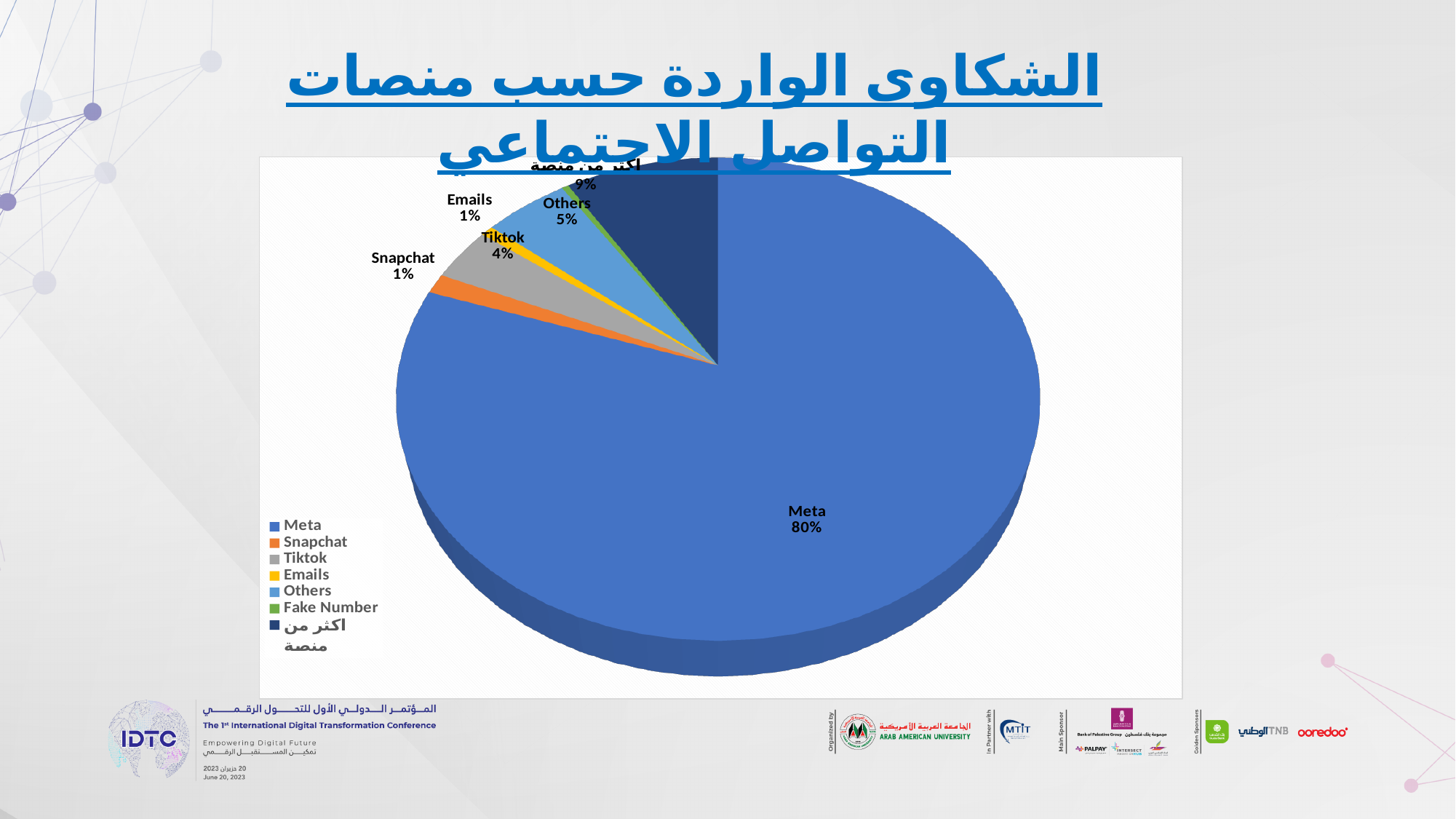
What percentage of complaints is attributed to Emails? 1% What colour is the Meta slice in the pie chart? Blue What percentage of complaints is attributed to Meta? 80% What percentage of complaints is attributed to Tiktok? 4% Which has a larger share of complaints, Others or Tiktok? Others How many percentage points larger is Meta's share than Tiktok's share? 76 What percentage of complaints is attributed to Snapchat? 1% How many categories does the legend of the pie chart list? 7 What percentage of complaints is attributed to Others? 5% Which platform accounts for the largest share of complaints? Meta What percentage of complaints is attributed to اكثر من منصة (more than one platform)? 9% What kind of chart is shown on the slide? Pie chart